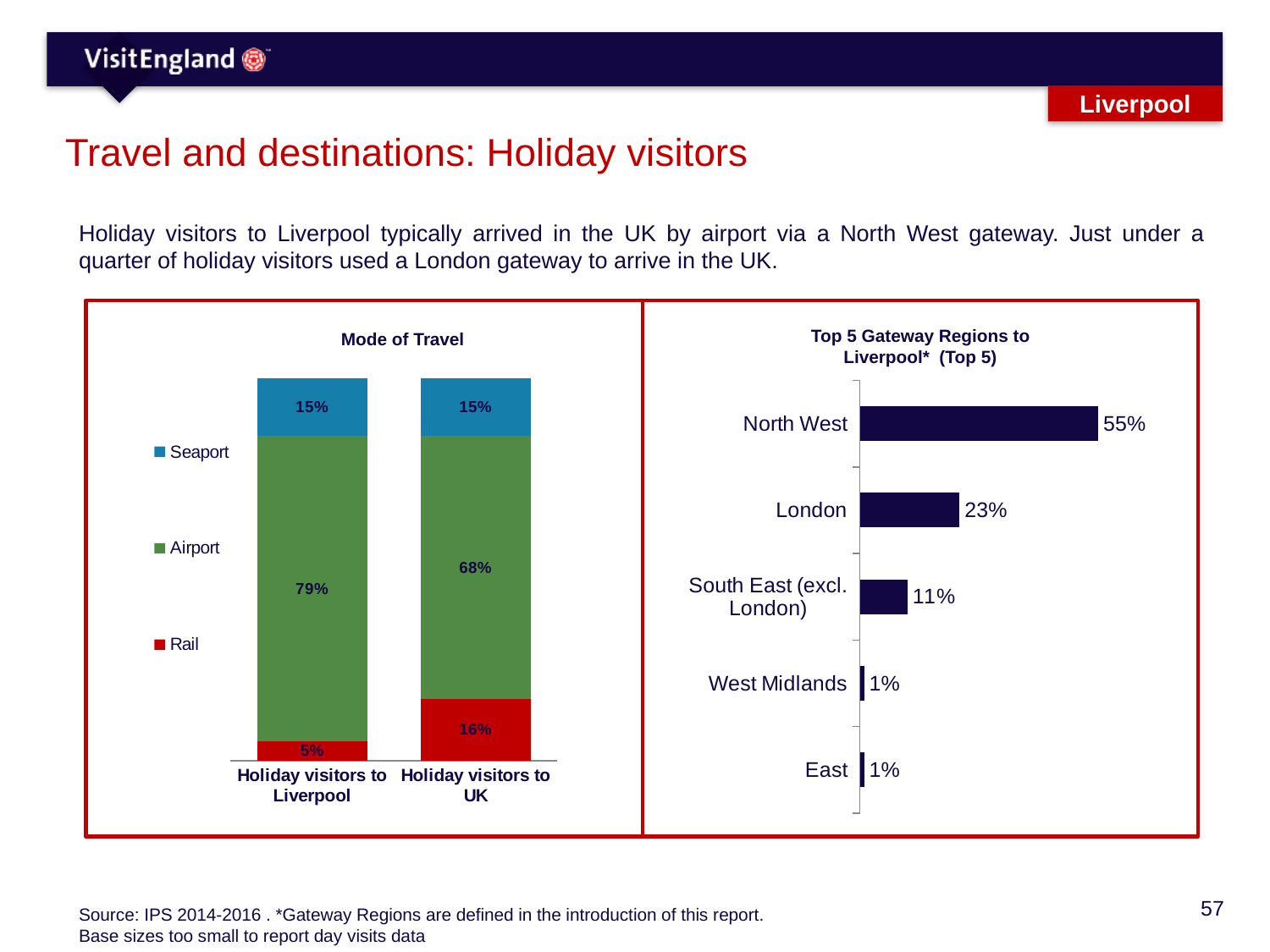
In the Top 5 Gateway Regions to Liverpool chart, what is the difference between North West and London? 32 percentage points In the Mode of Travel chart, which is larger: the rail share for holiday visitors to Liverpool or for holiday visitors to the UK? Holiday visitors to UK In the Mode of Travel chart, what percentage of holiday visitors to the UK arrived by rail? 16% In the Top 5 Gateway Regions to Liverpool chart, what is the value for London? 23% What kind of chart is the Mode of Travel chart? Stacked bar chart In the Mode of Travel chart, what percentage of holiday visitors to Liverpool arrived by airport? 79% How many series does the legend of the Mode of Travel chart list? 3 In the Top 5 Gateway Regions to Liverpool chart, which region has the highest value? North West How many regions are shown in the Top 5 Gateway Regions to Liverpool chart? 5 In the Mode of Travel chart, what is the difference between the airport share for holiday visitors to Liverpool and for holiday visitors to the UK? 11 percentage points In the Top 5 Gateway Regions to Liverpool chart, what is the value for South East (excl. London)? 11% In the Mode of Travel chart, which colour represents Seaport? Blue